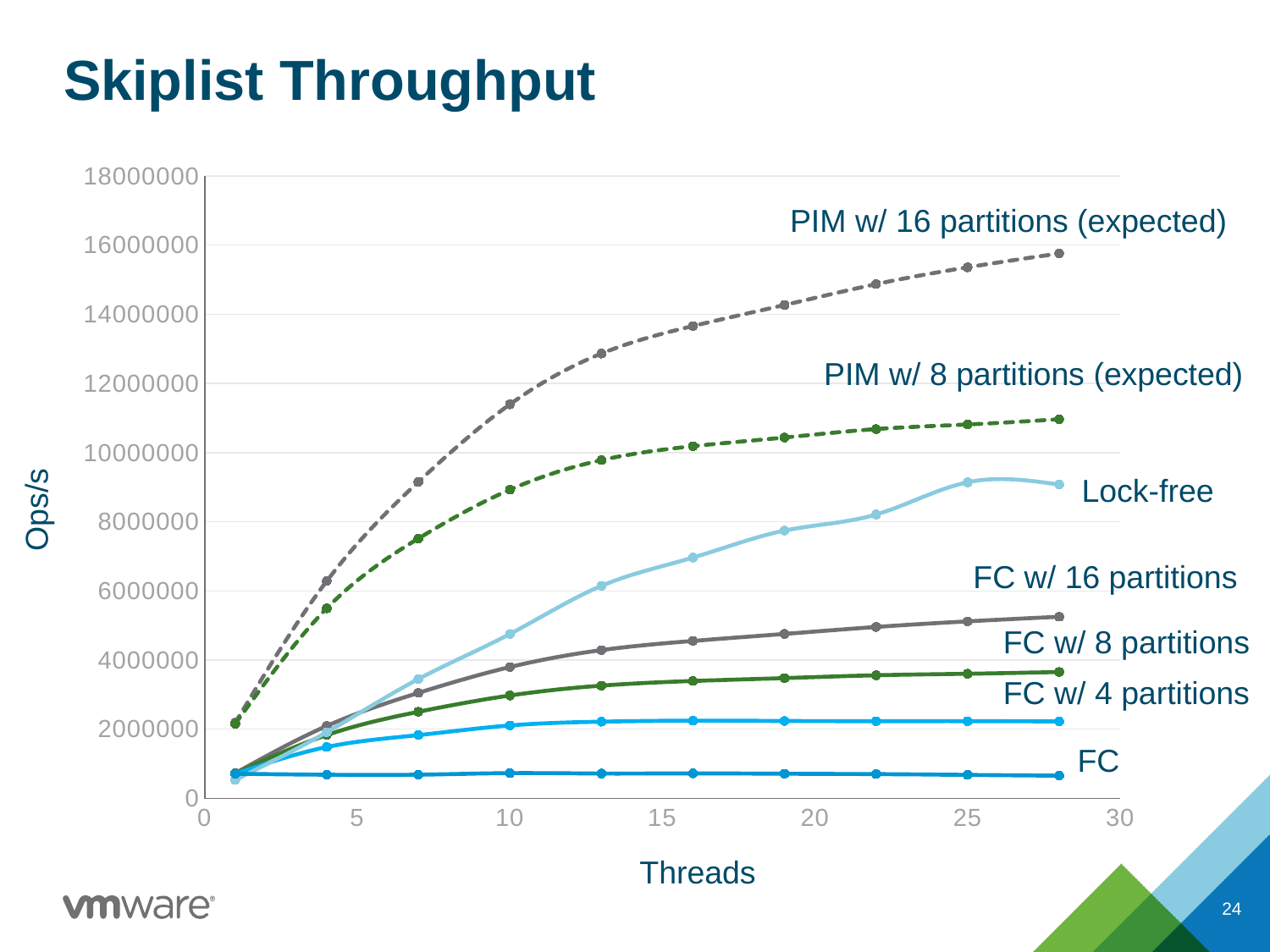
Which series has the highest throughput at 28 threads? PIM w/ 16 partitions (expected) Which series has the lowest throughput at 28 threads? FC Does the PIM w/ 16 partitions (expected) series rise or fall as the number of threads increases? rise Is the value for FC at 28 threads greater or less than 2000000? less What kind of chart is shown on the slide? line chart Is the value for FC w/ 8 partitions at 28 threads greater or less than 4000000? less What is the title of the chart? Skiplist Throughput At 28 threads, which is larger: Lock-free or FC w/ 16 partitions? Lock-free Is the value for Lock-free at 28 threads greater or less than 10000000? less What is the label of the x axis? Threads How many series are plotted on the chart? 7